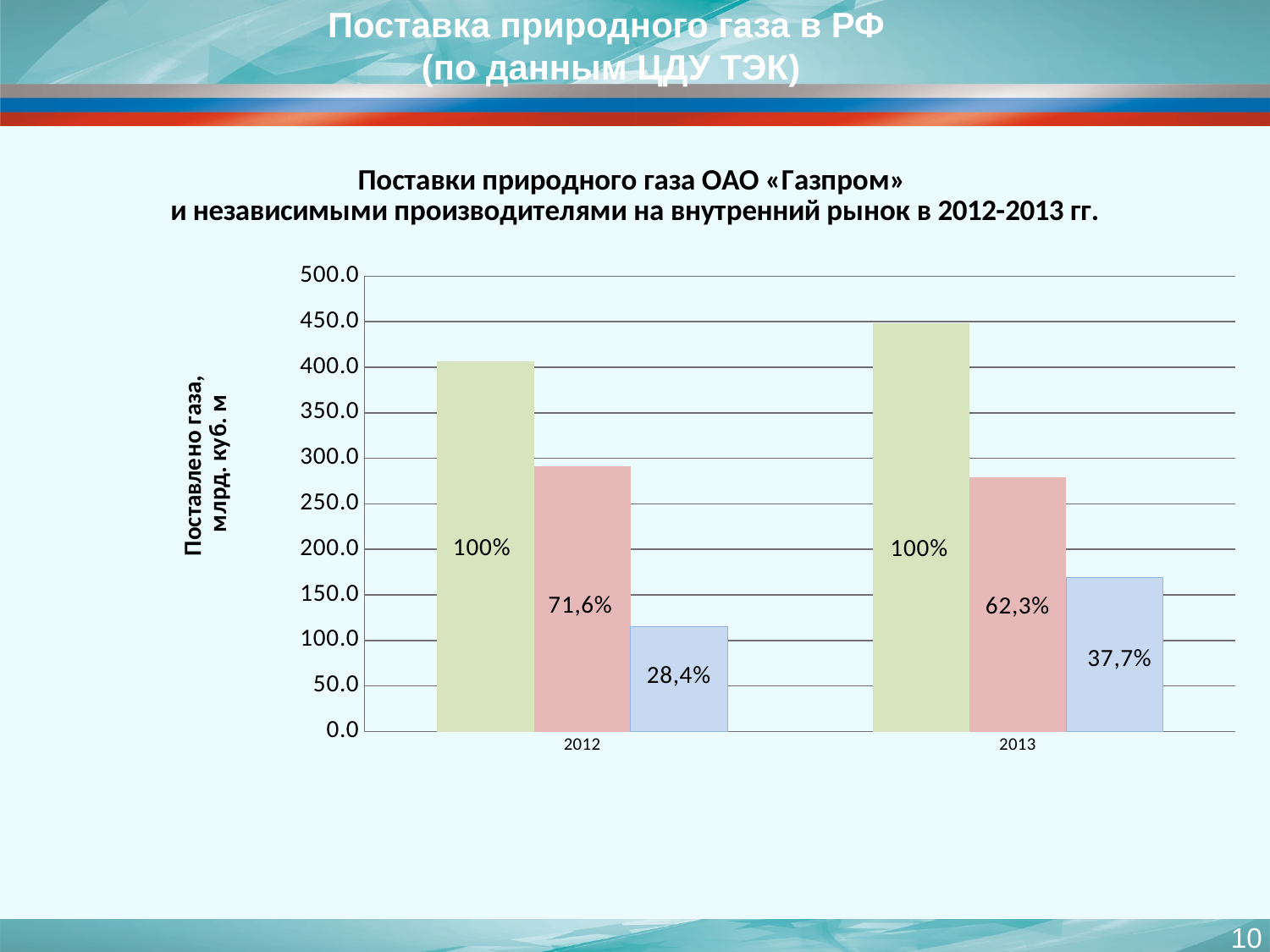
How many year categories are shown on the x axis? 2 Is the value of the blue (right) bar for 2013 greater or less than 200.0? less What is the label of the vertical axis? Поставлено газа, млрд. куб. м Does the green (left) bar rise or fall from 2012 to 2013? rise What percentage label is shown on the blue (right) bar for 2013? 37,7% Is the value of the green (left) bar for 2012 greater or less than 400.0? greater What percentage label is shown on the green (left) bar for 2013? 100% What type of chart is shown on the slide? bar chart What percentage label is shown on the blue (right) bar for 2012? 28,4% What percentage label is shown on the pink (middle) bar for 2012? 71,6% What percentage label is shown on the pink (middle) bar for 2013? 62,3% Which is larger in 2012, the pink (middle) bar or the blue (right) bar? the pink (middle) bar